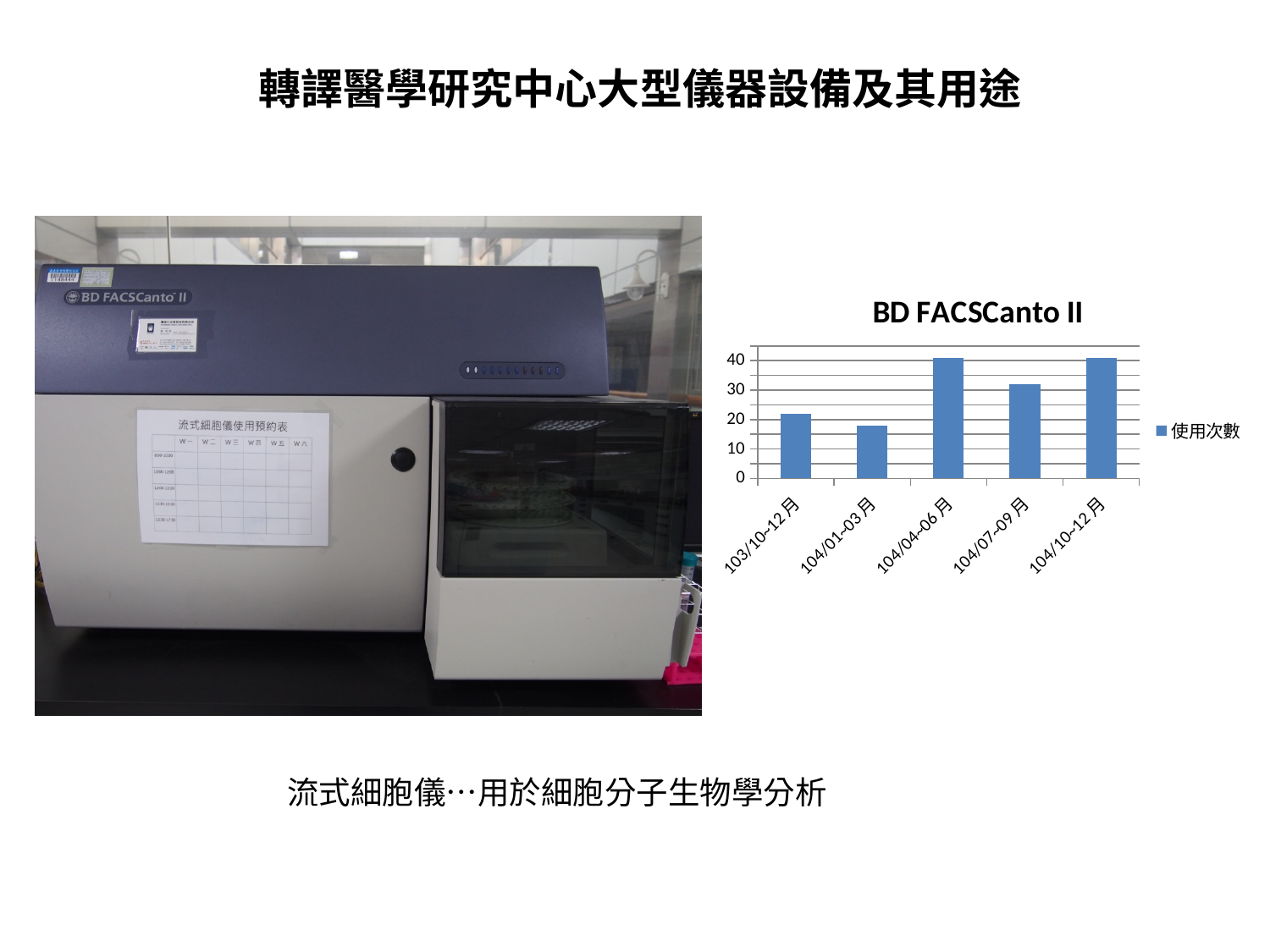
Is the value for 104/10~12月 greater or less than 30? greater Which is larger, the value for 104/01~03月 or the value for 104/10~12月? 104/10~12月 Is the value for 104/01~03月 greater or less than 20? less What is the title of the chart? BD FACSCanto II Is the value for 104/04~06月 greater or less than 30? greater How many categories are shown on the x axis of the chart? 5 Which is larger, the value for 104/04~06月 or the value for 104/07~09月? 104/04~06月 What series name is shown in the chart's legend? 使用次數 How many series does the chart's legend list? 1 What kind of chart is shown on the slide? bar chart Which period has the lowest value in the chart? 104/01~03月